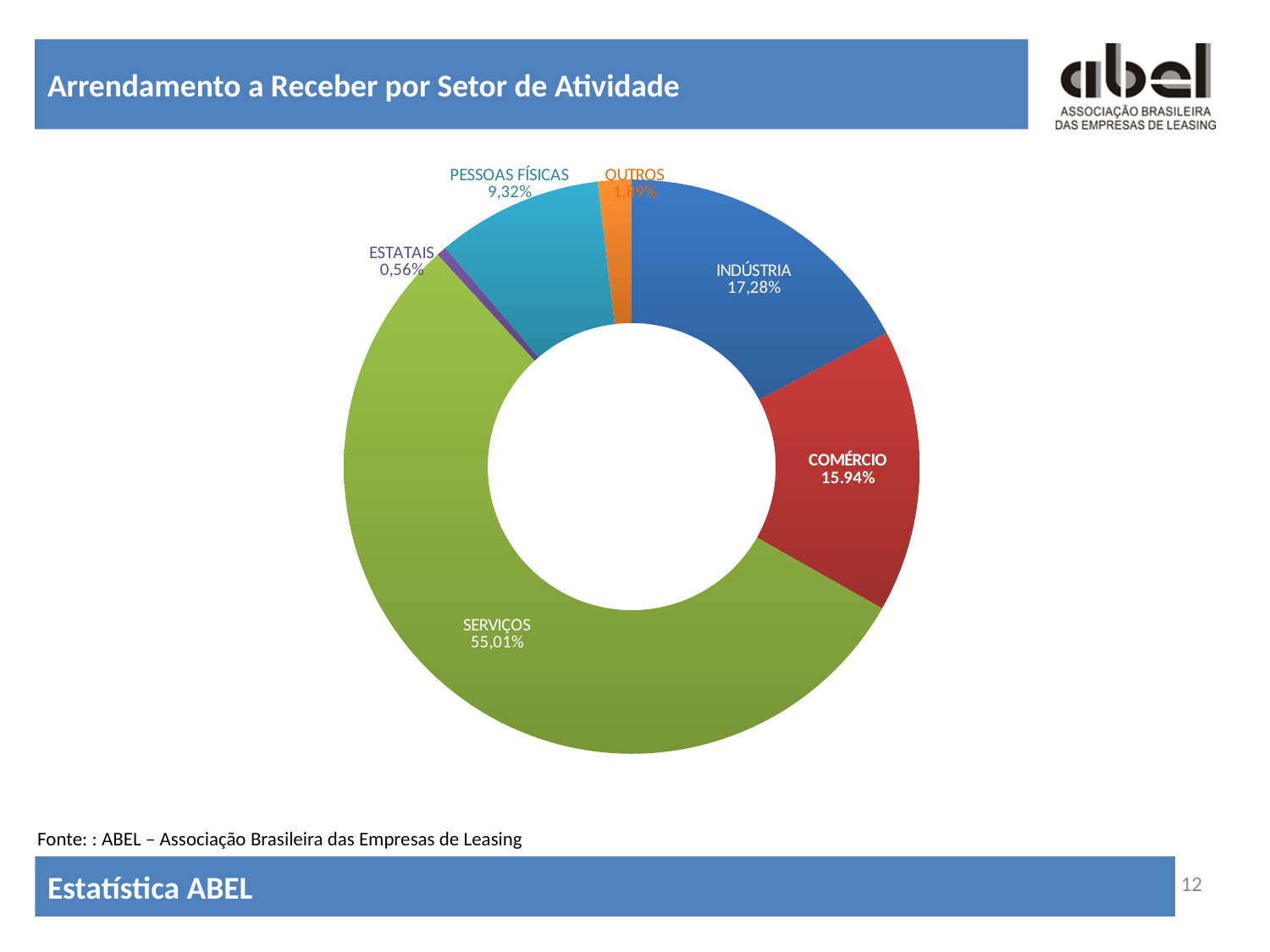
Which sector has the smallest share of the chart? ESTATAIS What kind of chart is shown on the slide? Pie (donut) chart What percentage is shown for ESTATAIS? 0,56% What percentage is shown for COMÉRCIO? 15.94% What is the title of the chart on the slide? Arrendamento a Receber por Setor de Atividade How many sectors (slices) are shown in the chart? 6 What percentage is shown for PESSOAS FÍSICAS? 9,32% What percentage is shown for INDÚSTRIA? 17,28% What percentage is shown for SERVIÇOS? 55,01% Which is larger, the share for INDÚSTRIA or the share for PESSOAS FÍSICAS? INDÚSTRIA Which sector has the largest share of the chart? SERVIÇOS What is the difference in percentage points between SERVIÇOS and INDÚSTRIA? 37,73 percentage points